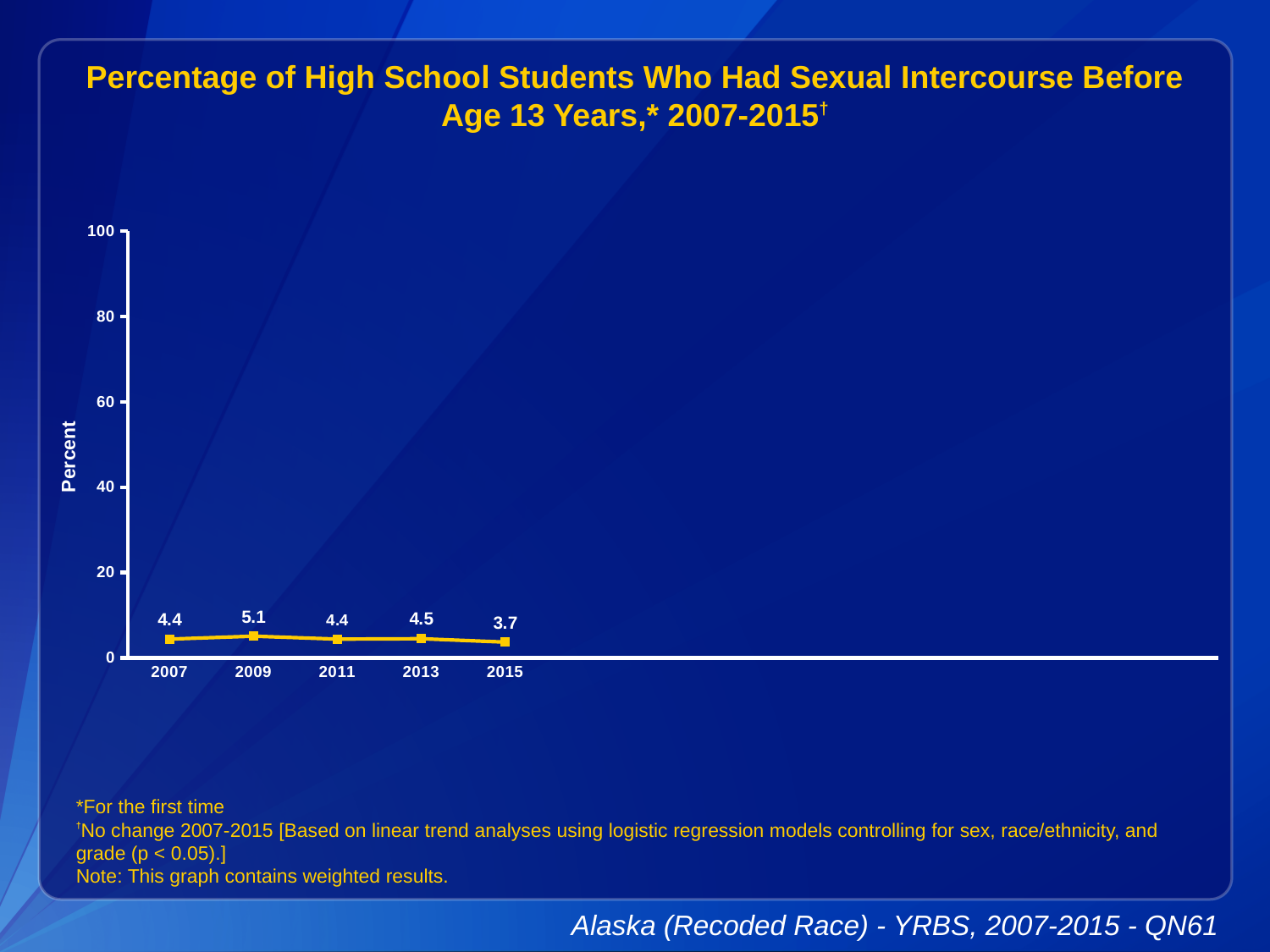
How many years are plotted on the chart? 5 What is the value for 2009? 5.1 What is the value for 2007? 4.4 What is the label of the y axis? Percent Which year has the lowest value? 2015 What is the value for 2015? 3.7 Which is larger, the value for 2013 or the value for 2015? 2013 What kind of chart is shown? line chart Is the value for 2009 greater or less than 20? less What is the difference between the values for 2009 and 2015? 1.4 What is the maximum value shown on the y axis? 100 Which year has the highest value? 2009